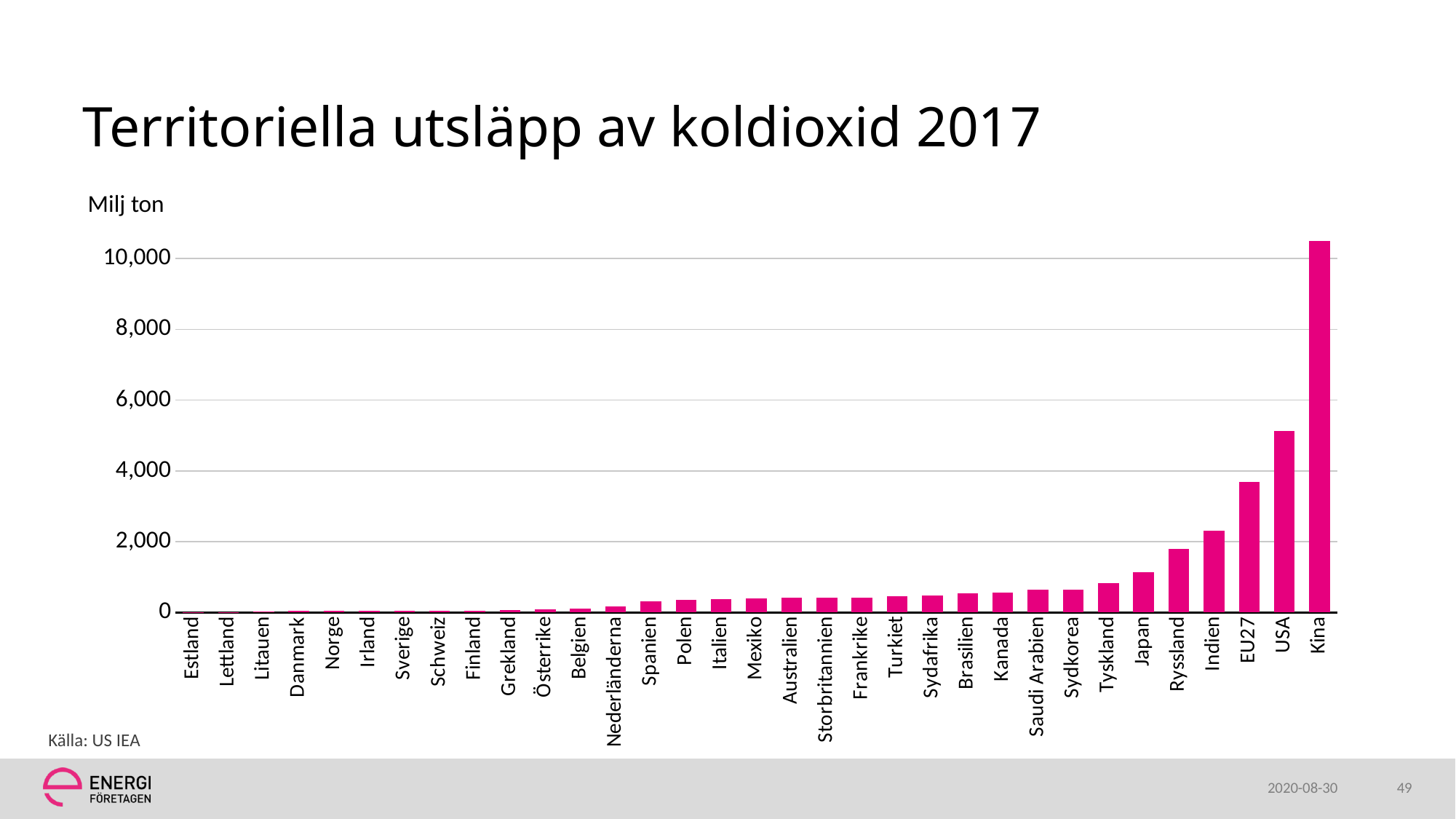
Is the value for USA greater or less than 6,000? less What unit is given for the y axis of the chart? Milj ton Is the value for USA greater or less than 4,000? greater Which has the larger value, USA or EU27? USA Do the values rise or fall from left to right along the x axis? rise Is the value for Indien greater or less than 2,000? greater How many countries or regions are shown on the x axis of the chart? 33 Which has the larger value, Indien or Ryssland? Indien What kind of chart is shown on the slide? bar chart Which country has the highest territorial CO2 emissions in the chart? Kina